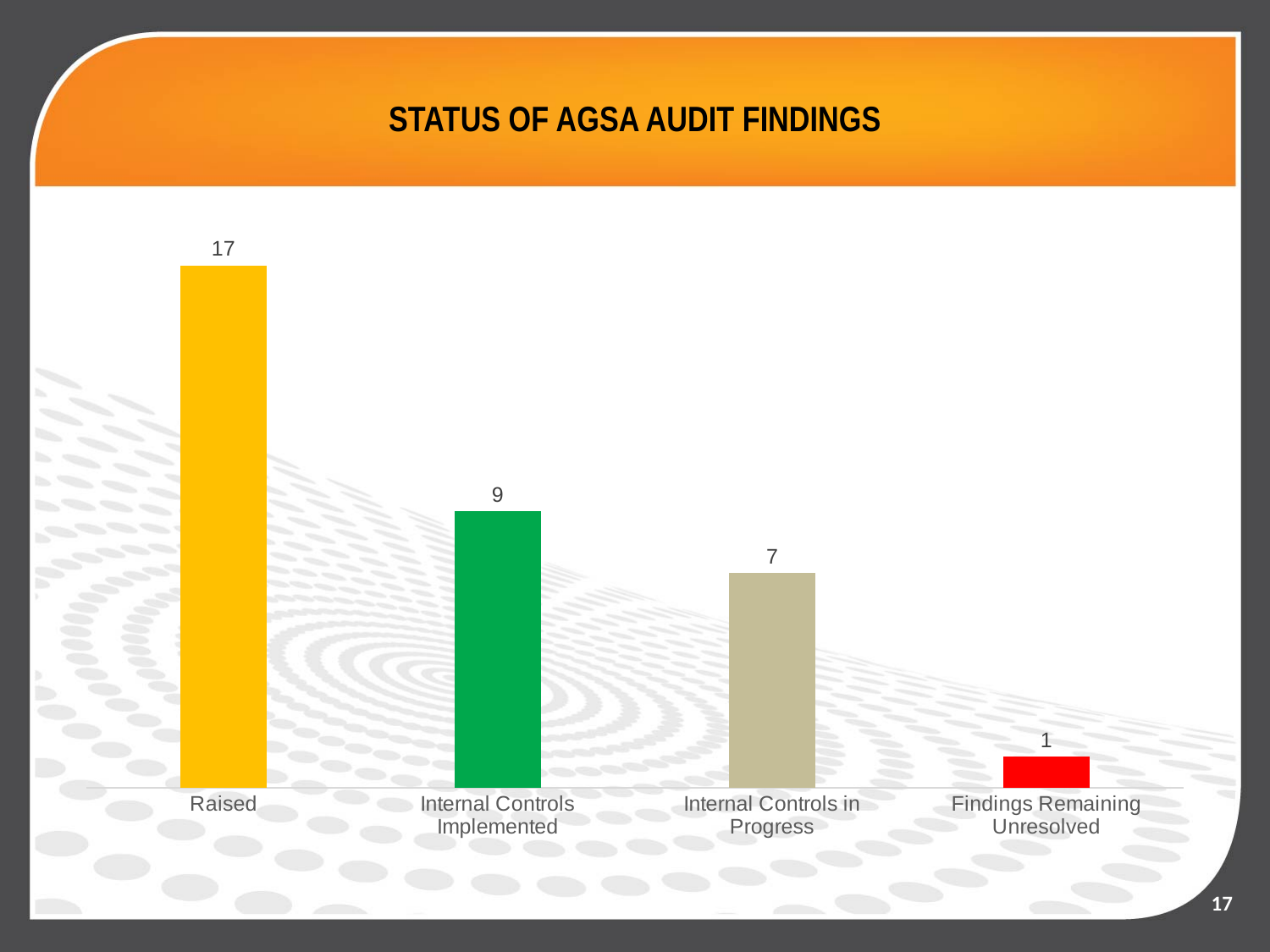
What is the value for Findings Remaining Unresolved? 1 Which category has the lowest value? Findings Remaining Unresolved How many categories are shown in the chart? 4 What kind of chart is shown on the slide? Bar chart What is the value for Internal Controls in Progress? 7 Which category has the highest value? Raised What is the difference between the values for Internal Controls Implemented and Internal Controls in Progress? 2 What is the difference between the values for Raised and Internal Controls Implemented? 8 What is the title of the slide containing the chart? STATUS OF AGSA AUDIT FINDINGS Which is larger, the value for Internal Controls in Progress or the value for Findings Remaining Unresolved? Internal Controls in Progress What is the value for Raised? 17 What is the value for Internal Controls Implemented? 9